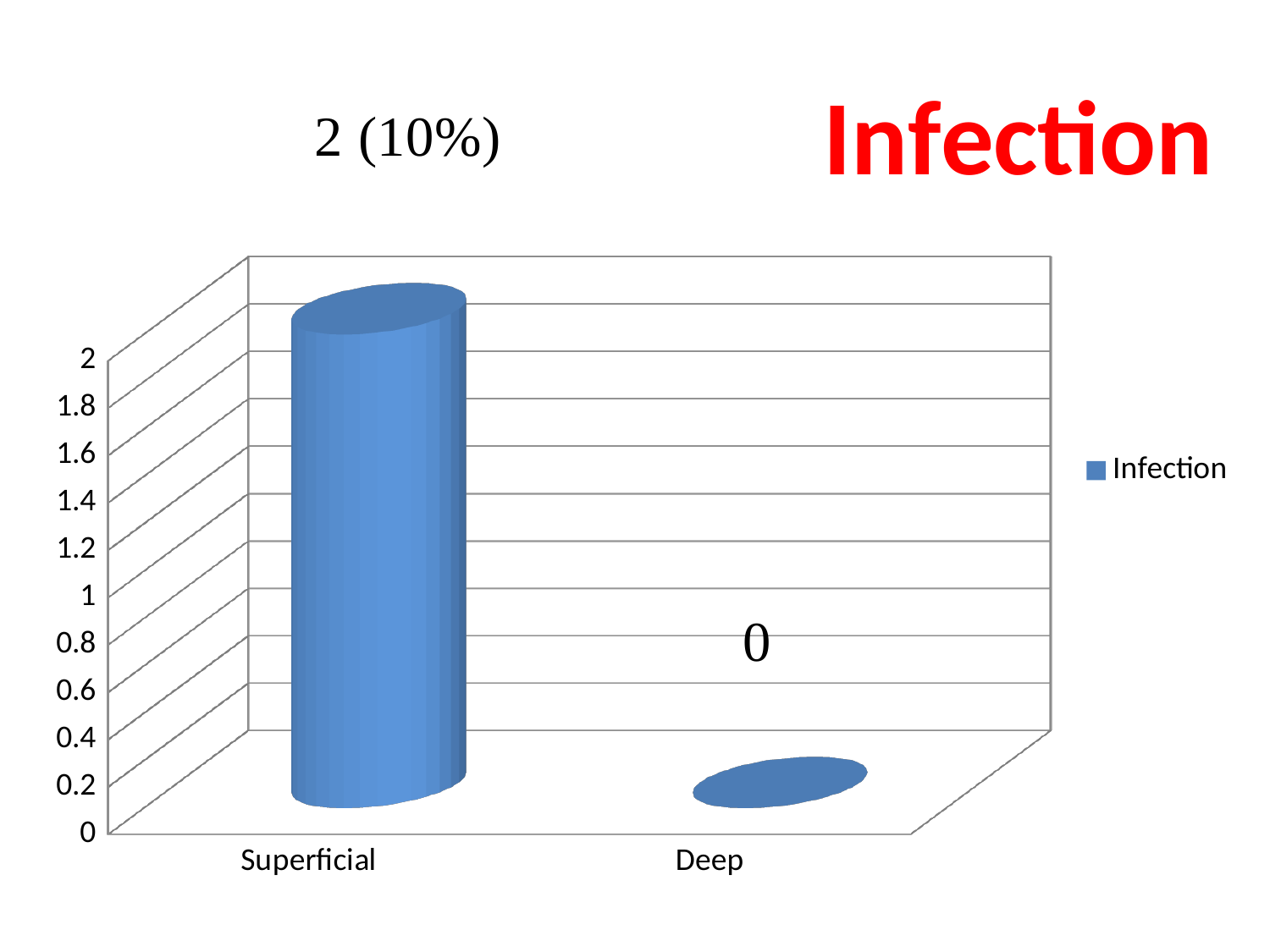
What is the difference between the Superficial and Deep values? 2 What is the value for Superficial infection? 2 What is the name of the series in the legend? Infection What percentage is shown next to the Superficial count on the slide? 10% How many series does the legend list? 1 Which is larger, the value for Superficial or the value for Deep? Superficial Which category has the lowest value? Deep Which category has the highest value? Superficial What kind of chart is shown on the slide? bar chart What is the value for Deep infection? 0 Is the value for Superficial greater or less than 1? greater How many categories are shown on the x axis of the chart? 2